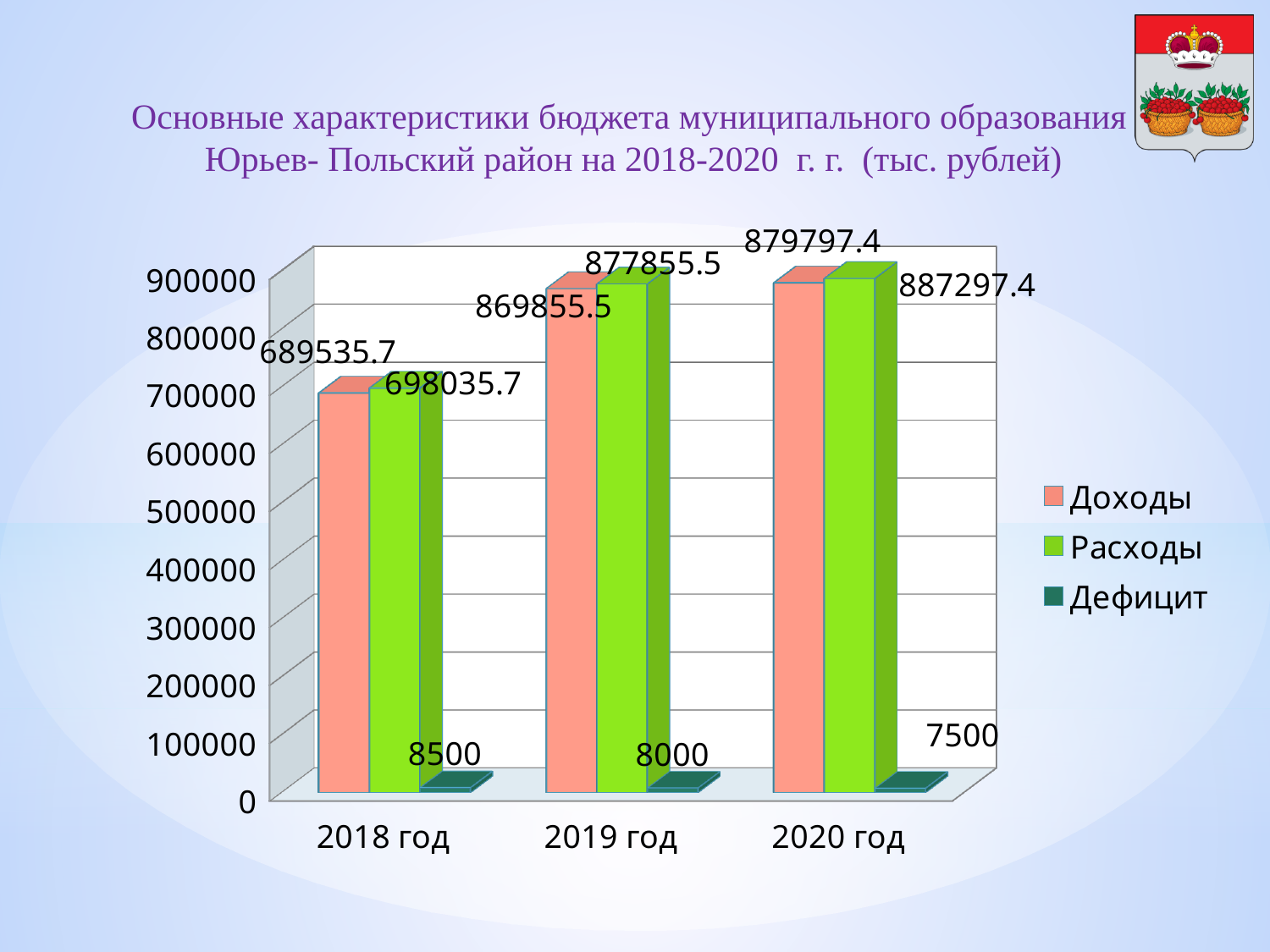
What kind of chart is shown on the slide? bar chart What is the difference between Расходы and Доходы in 2019 год? 8000 What is the value of Доходы for 2018 год? 689535.7 How many years are shown on the x axis? 3 Is the value of Расходы for 2018 год greater or less than 800000? less Do the Дефицит values rise or fall from 2018 год to 2020 год? fall In which year is Дефицит the lowest? 2020 год What is the value of Расходы for 2020 год? 887297.4 Which is larger in 2018 год, Доходы or Расходы? Расходы What is the value of Дефицит for 2019 год? 8000 In which year is Доходы the highest? 2020 год How many series does the legend list? 3